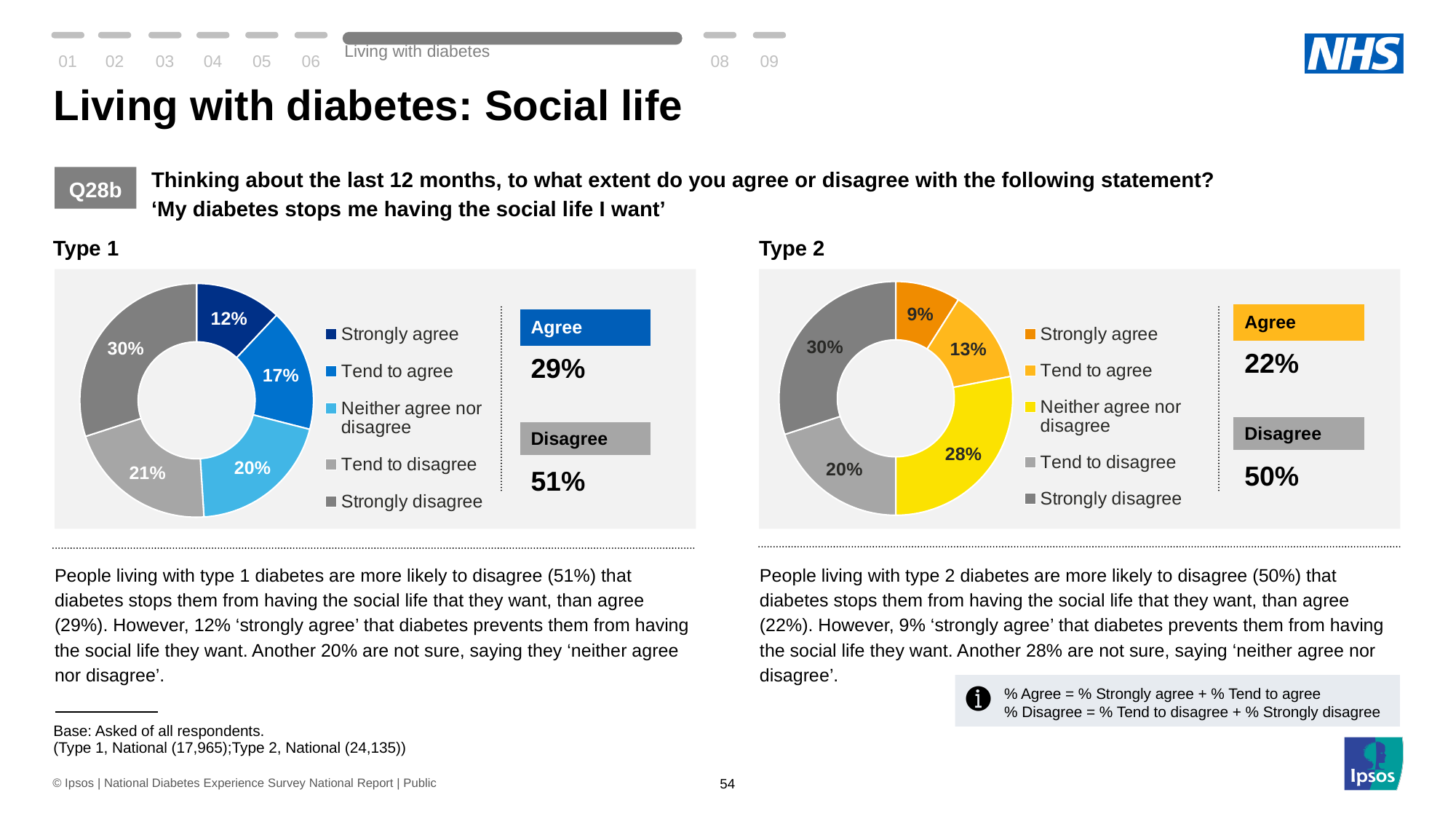
How many response categories does the Type 1 chart's legend list? 5 In the Type 2 chart, which response category has the smallest share? Strongly agree In the Type 1 chart, which response category has the largest share? Strongly disagree In the Type 2 chart, which is larger: 'tend to agree' or 'tend to disagree'? Tend to disagree In the Type 2 chart, what is the combined 'Disagree' percentage shown? 50% What kind of chart is used for the Type 2 data? Doughnut (pie) chart In the Type 2 chart, what percentage of respondents 'neither agree nor disagree'? 28% In the Type 2 chart, what percentage of respondents 'tend to agree'? 13% In the Type 1 chart, what is the difference between the 'tend to disagree' and 'tend to agree' percentages? 4 percentage points In the Type 1 chart, what percentage of respondents 'strongly agree'? 12% In the Type 1 chart, what is the combined 'Agree' percentage shown? 29% What colour represents 'Strongly disagree' in both charts? Dark grey